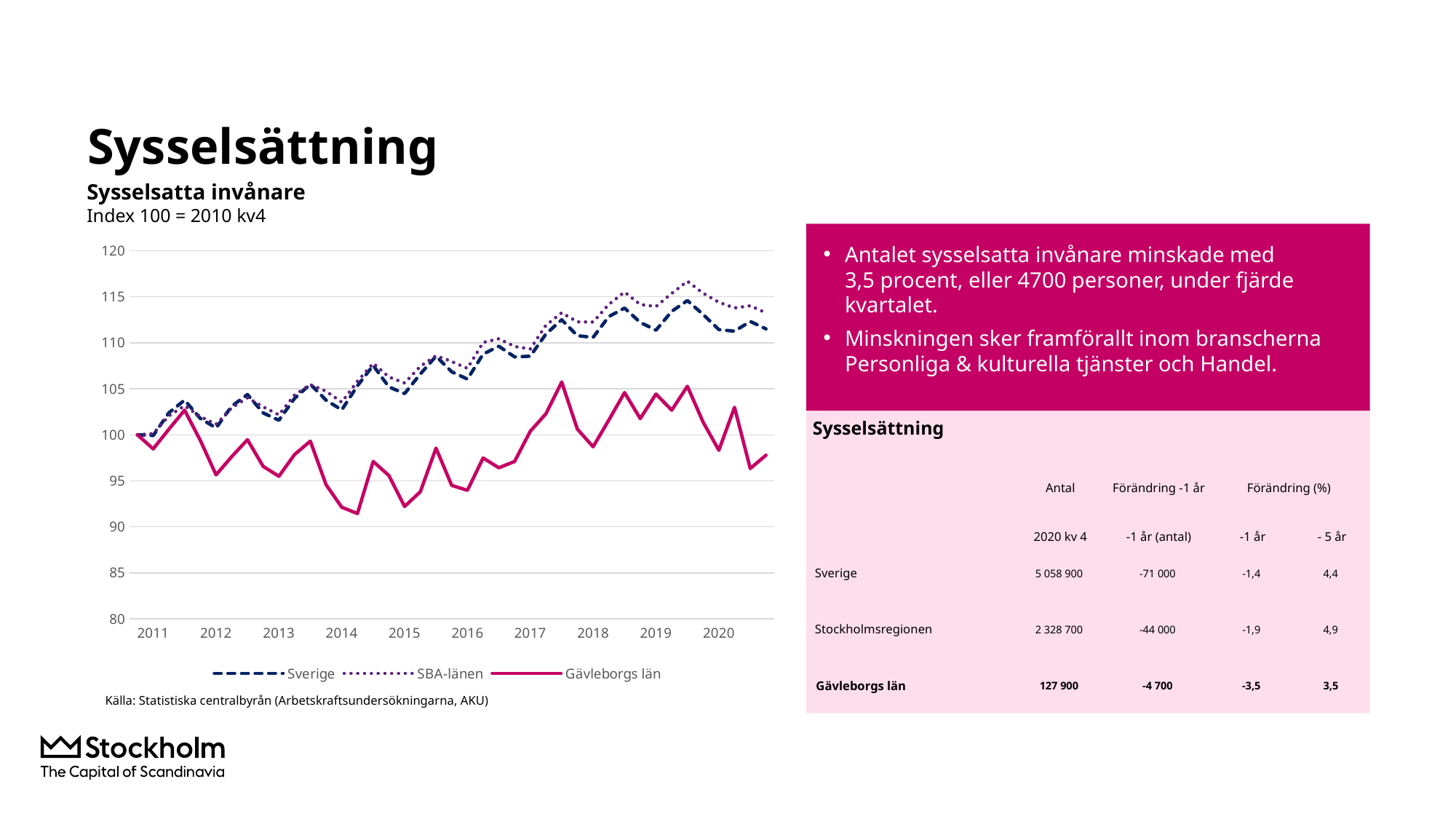
Does the Sverige series generally rise or fall from 2011 to 2019? rise Is the lowest value for Gävleborgs län in 2014 greater or less than 95? less Which series has the highest value at the end of 2020? SBA-länen What is the index base stated under the chart title 'Sysselsatta invånare'? Index 100 = 2010 kv4 Is the value for Gävleborgs län at the end of 2020 greater or less than 100? less Which series are listed in the chart legend? Sverige, SBA-länen, Gävleborgs län How many series does the chart legend list? 3 How many years are labelled on the x axis of the chart? 10 Is the highest value for SBA-länen in 2019 greater or less than 115? greater Which series has the lowest value at the end of 2020? Gävleborgs län What kind of chart is shown on the slide? line chart